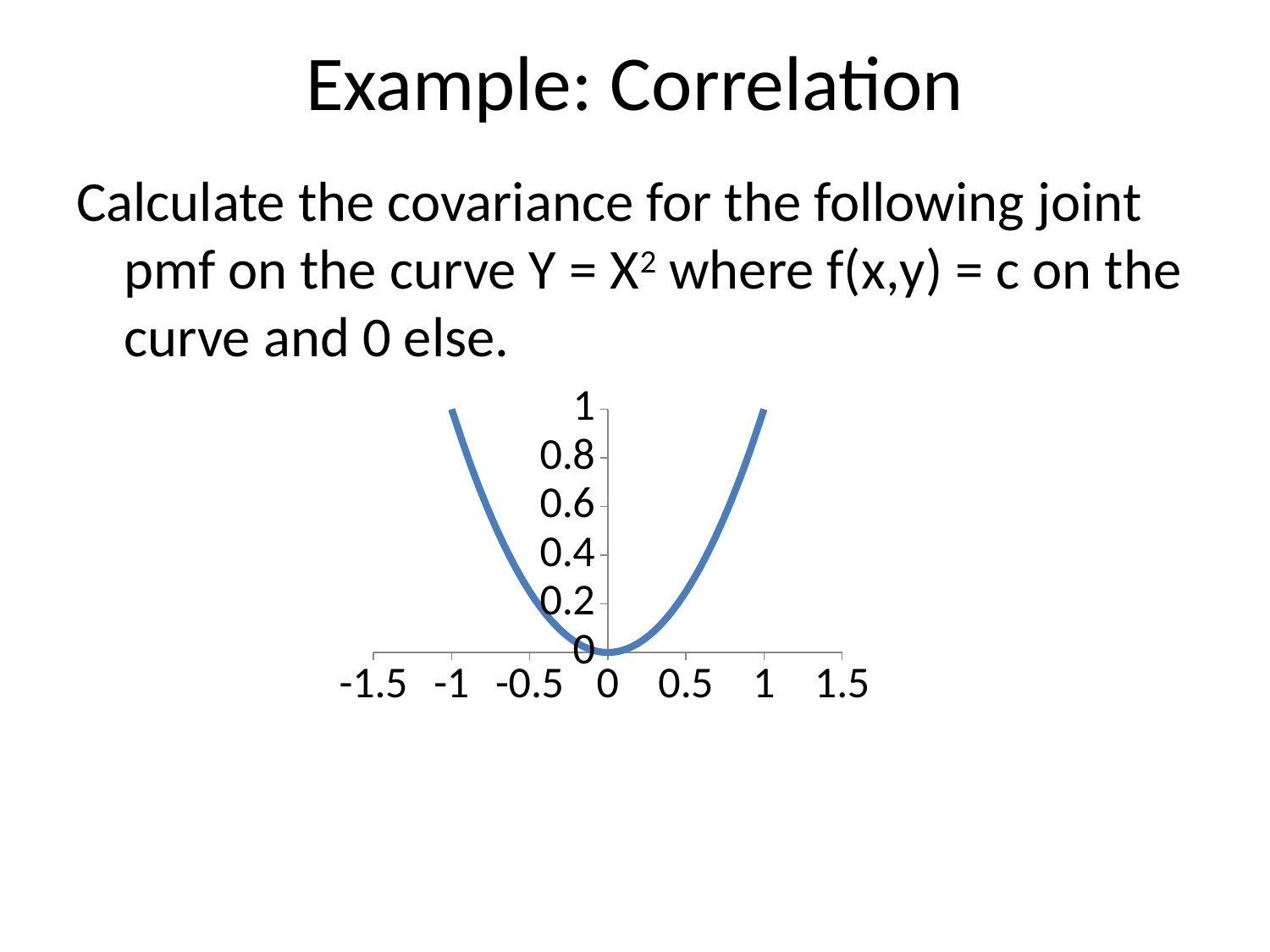
What is the value of the curve at x = -1? 1 What colour is the plotted curve? blue Which is larger, the value of the curve at x = 0.5 or at x = 1? x = 1 At which x value does the curve reach its lowest point? 0 Is the value of the curve at x = 0.5 greater or less than 0.4? less Does the curve rise or fall as x increases from 0 to 1? rises What is the value of the curve at x = 1? 1 What is the value of the curve at x = 0? 0 How many tick labels are shown on the x axis? 7 Is the value of the curve at x = 0.8 greater or less than 0.4? greater What kind of chart is shown on the slide? line chart